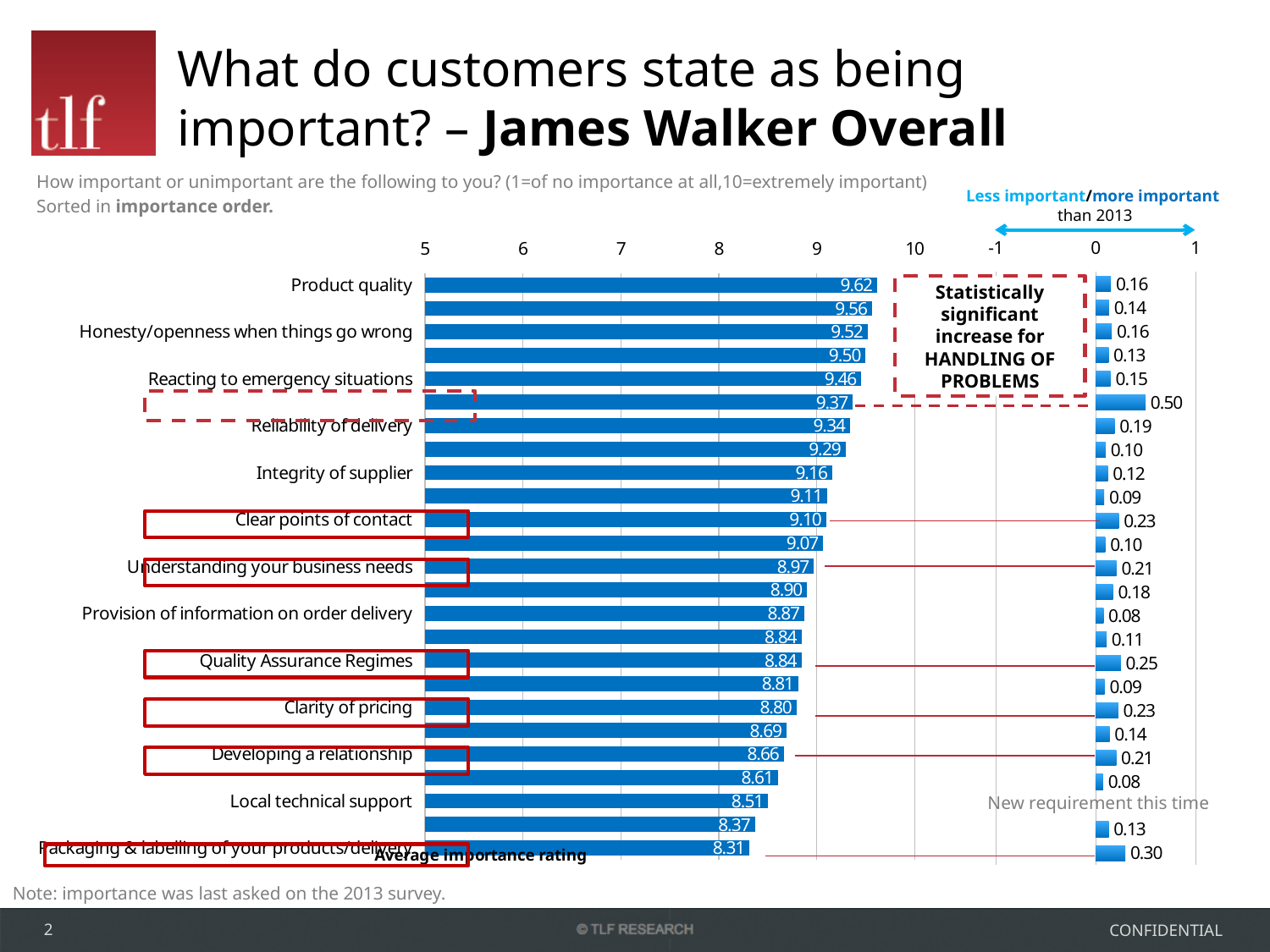
What is the average importance rating for Product quality? 9.62 Which labelled category has the lowest average importance rating? Packaging & labelling of your products/delivery Is the average importance rating for Local technical support greater or less than 9? less What is the difference between the average importance ratings for Product quality and Packaging & labelling of your products/delivery? 1.31 How many bars are plotted in the average importance rating chart? 25 What is the average importance rating for Reacting to emergency situations? 9.46 Which labelled category has the highest average importance rating? Product quality In the right-hand chart showing change versus 2013, what is the value for Quality Assurance Regimes? 0.25 What is the average importance rating for Clarity of pricing? 8.80 In the right-hand chart showing change versus 2013, what is shown for Local technical support instead of a value? New requirement this time What kind of chart is used to show the average importance ratings? bar chart Which has a higher average importance rating, Reliability of delivery or Integrity of supplier? Reliability of delivery